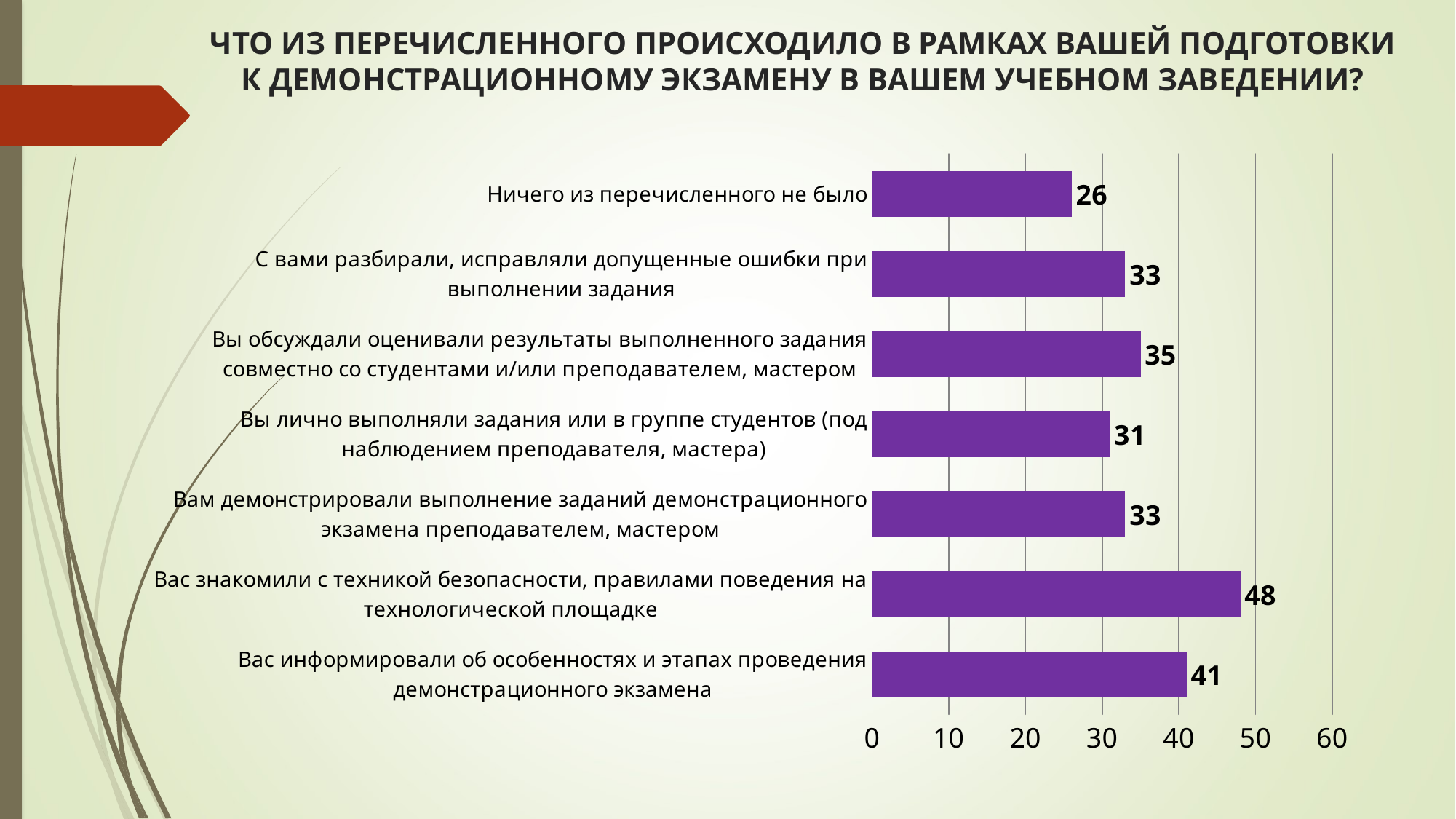
What is the value for "Вас знакомили с техникой безопасности, правилами поведения на технологической площадке"? 48 What is the value for "Ничего из перечисленного не было"? 26 What kind of chart is shown on the slide? bar chart What is the difference between the values for "Вас знакомили с техникой безопасности, правилами поведения на технологической площадке" and "Вас информировали об особенностях и этапах проведения демонстрационного экзамена"? 7 Which category has the highest value? Вас знакомили с техникой безопасности, правилами поведения на технологической площадке How many categories are shown in the chart? 7 Which is larger: the value for "Вы обсуждали оценивали результаты выполненного задания совместно со студентами и/или преподавателем, мастером" or for "Вы лично выполняли задания или в группе студентов (под наблюдением преподавателя, мастера)"? Вы обсуждали оценивали результаты выполненного задания совместно со студентами и/или преподавателем, мастером Is the value for "Ничего из перечисленного не было" greater or less than 30? less What is the value for "Вас информировали об особенностях и этапах проведения демонстрационного экзамена"? 41 What is the value for "Вы лично выполняли задания или в группе студентов (под наблюдением преподавателя, мастера)"? 31 Which category has the lowest value? Ничего из перечисленного не было What is the maximum value shown on the horizontal axis? 60